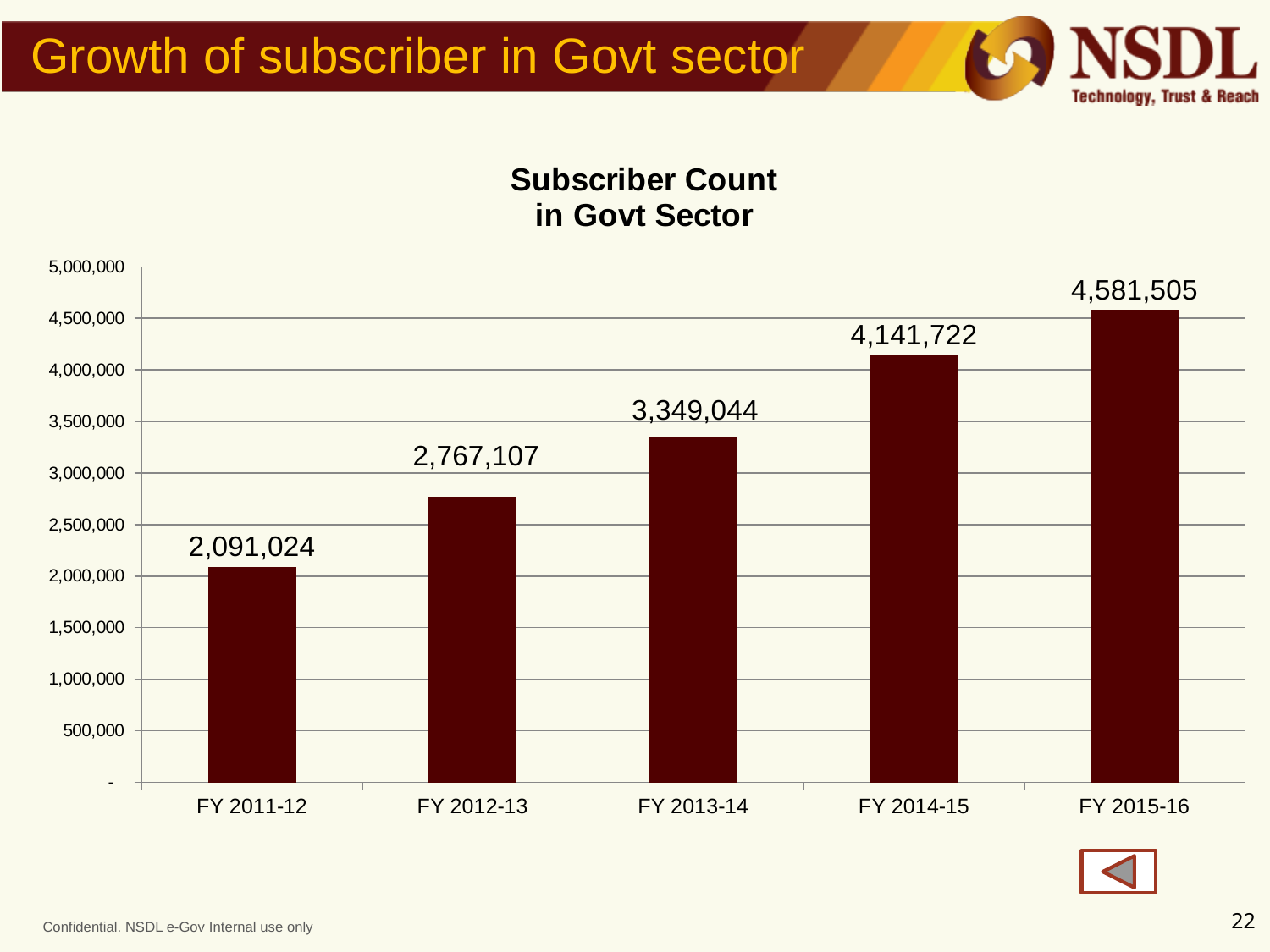
Which fiscal year has the lowest subscriber count? FY 2011-12 What is the difference in subscriber count between FY 2015-16 and FY 2014-15? 439,783 Does the subscriber count rise or fall from FY 2011-12 to FY 2015-16? rise Is the subscriber count for FY 2013-14 greater or less than 3,500,000? less What kind of chart is shown on the slide? bar chart Which fiscal year has the highest subscriber count? FY 2015-16 What is the difference in subscriber count between FY 2012-13 and FY 2011-12? 676,083 Which has a larger subscriber count, FY 2012-13 or FY 2014-15? FY 2014-15 What is the subscriber count for FY 2013-14? 3,349,044 What is the subscriber count for FY 2011-12? 2,091,024 What is the subscriber count for FY 2015-16? 4,581,505 How many fiscal years are shown on the chart? 5